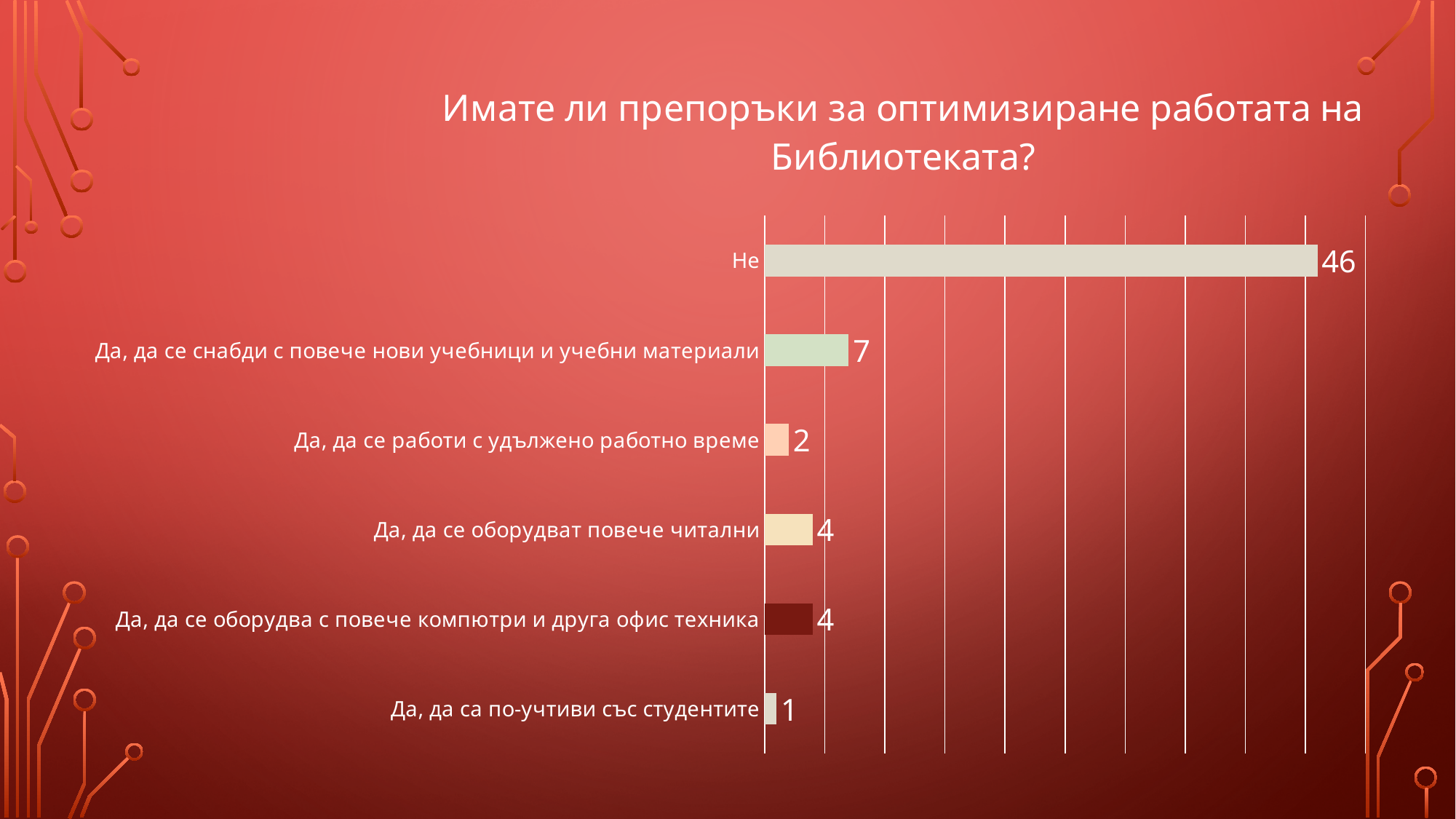
What is the difference between the values for "Да, да се оборудват повече читални" and "Да, да са по-учтиви със студентите"? 3 What is the title of the chart? Имате ли препоръки за оптимизиране работата на Библиотеката? Which is larger: the value for "Да, да се оборудват повече читални" or the value for "Да, да се работи с удължено работно време"? Да, да се оборудват повече читални Which category has the lowest value? Да, да са по-учтиви със студентите What is the value for "Да, да се снабди с повече нови учебници и учебни материали"? 7 What is the value for "Не"? 46 What is the value for "Да, да са по-учтиви със студентите"? 1 How many categories are shown in the chart? 6 Which category has the highest value? Не What is the value for "Да, да се работи с удължено работно време"? 2 What is the difference between the values for "Не" and "Да, да се снабди с повече нови учебници и учебни материали"? 39 What kind of chart is shown on the slide? Bar chart